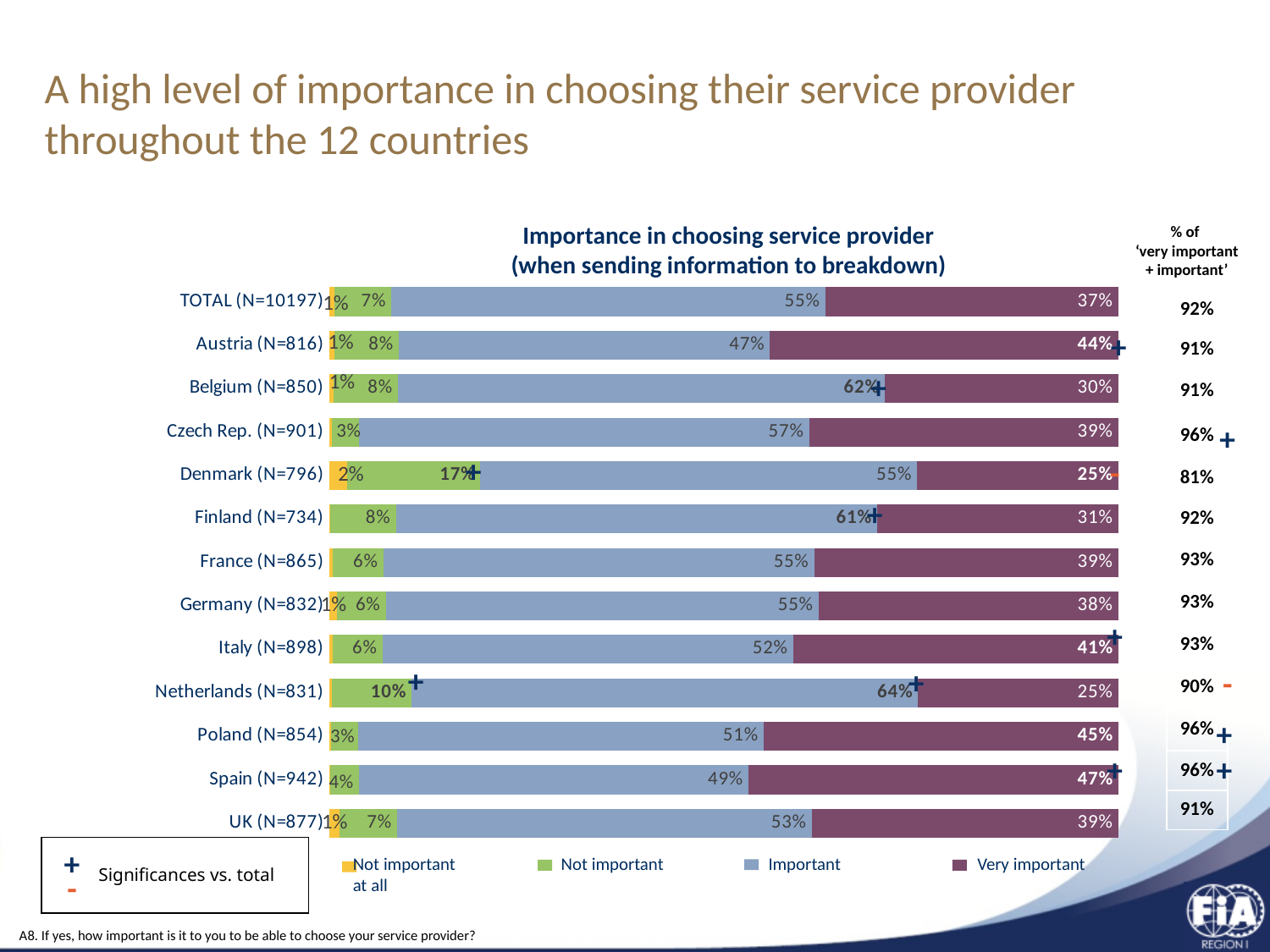
Which country has the highest 'Very important' value? Spain (N=942) What is the title of the chart? Importance in choosing service provider (when sending information to breakdown) What is the 'Very important' value for Spain (N=942)? 47% How many bars (categories) are plotted in the chart? 13 How many series does the legend list? 4 What is the 'Not important' value for Denmark (N=796)? 17% What is the difference between the 'Very important' values for Spain (N=942) and Netherlands (N=831)? 22 percentage points What kind of chart is shown on the slide? Stacked bar chart Which is larger: the 'Important' value for Belgium (N=850) or for Austria (N=816)? Belgium (N=850) Which category has the lowest 'Important' value? Austria (N=816) Which category has the highest 'Important' value? Netherlands (N=831) What is the 'Important' value for Belgium (N=850)? 62%